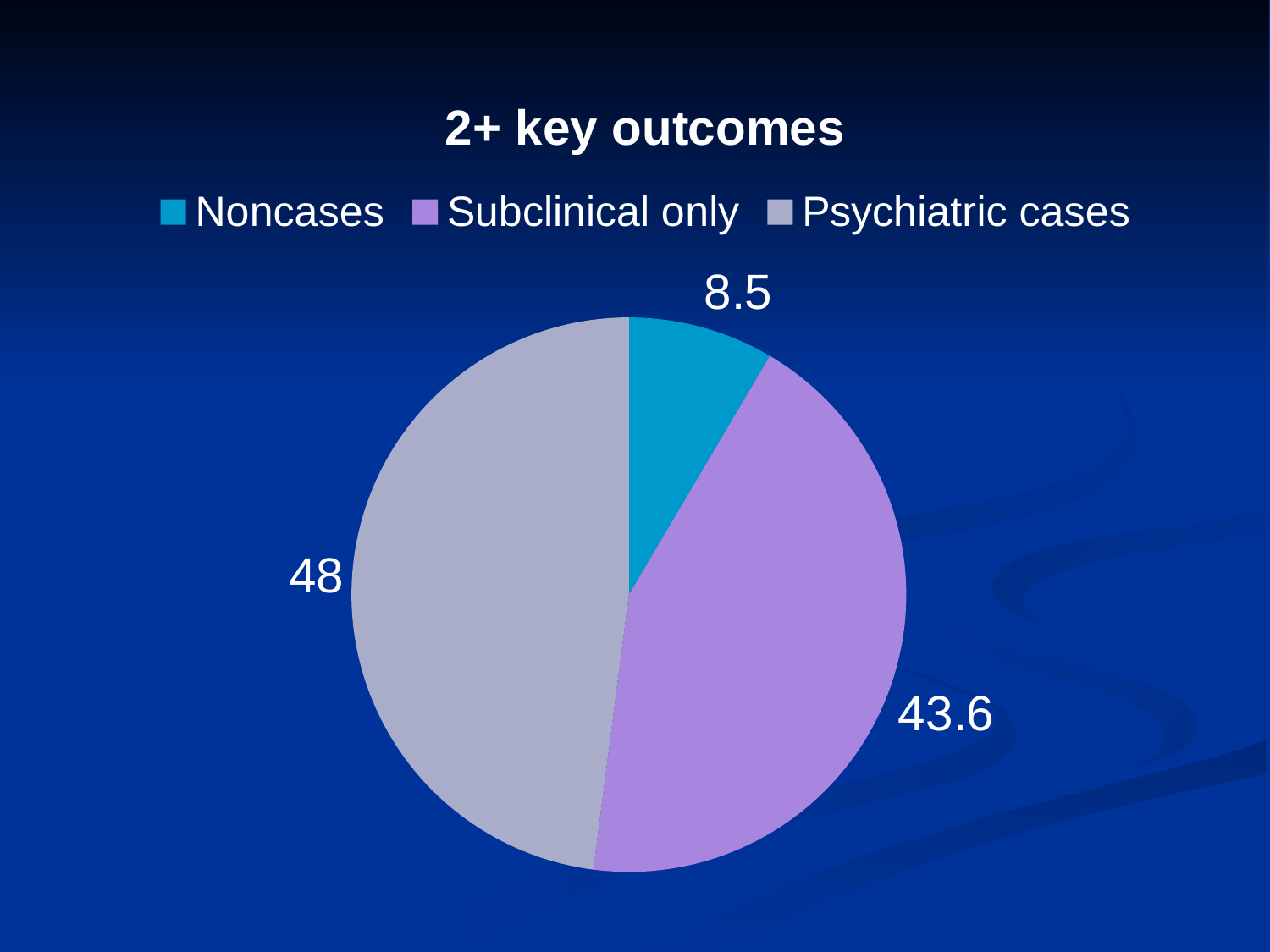
What is the value labelled for the Noncases slice? 8.5 What is the title of the chart? 2+ key outcomes Which category has the smallest slice of the pie? Noncases Which category has the largest slice of the pie? Psychiatric cases What is the difference between the values for Psychiatric cases and Subclinical only? 4.4 What is the value labelled for the Psychiatric cases slice? 48 How many entries does the legend list? 3 Which is larger, the value for Subclinical only or the value for Noncases? Subclinical only How many slices does the pie chart have? 3 What is the difference between the values for Subclinical only and Noncases? 35.1 What is the value labelled for the Subclinical only slice? 43.6 What type of chart is shown on the slide? pie chart